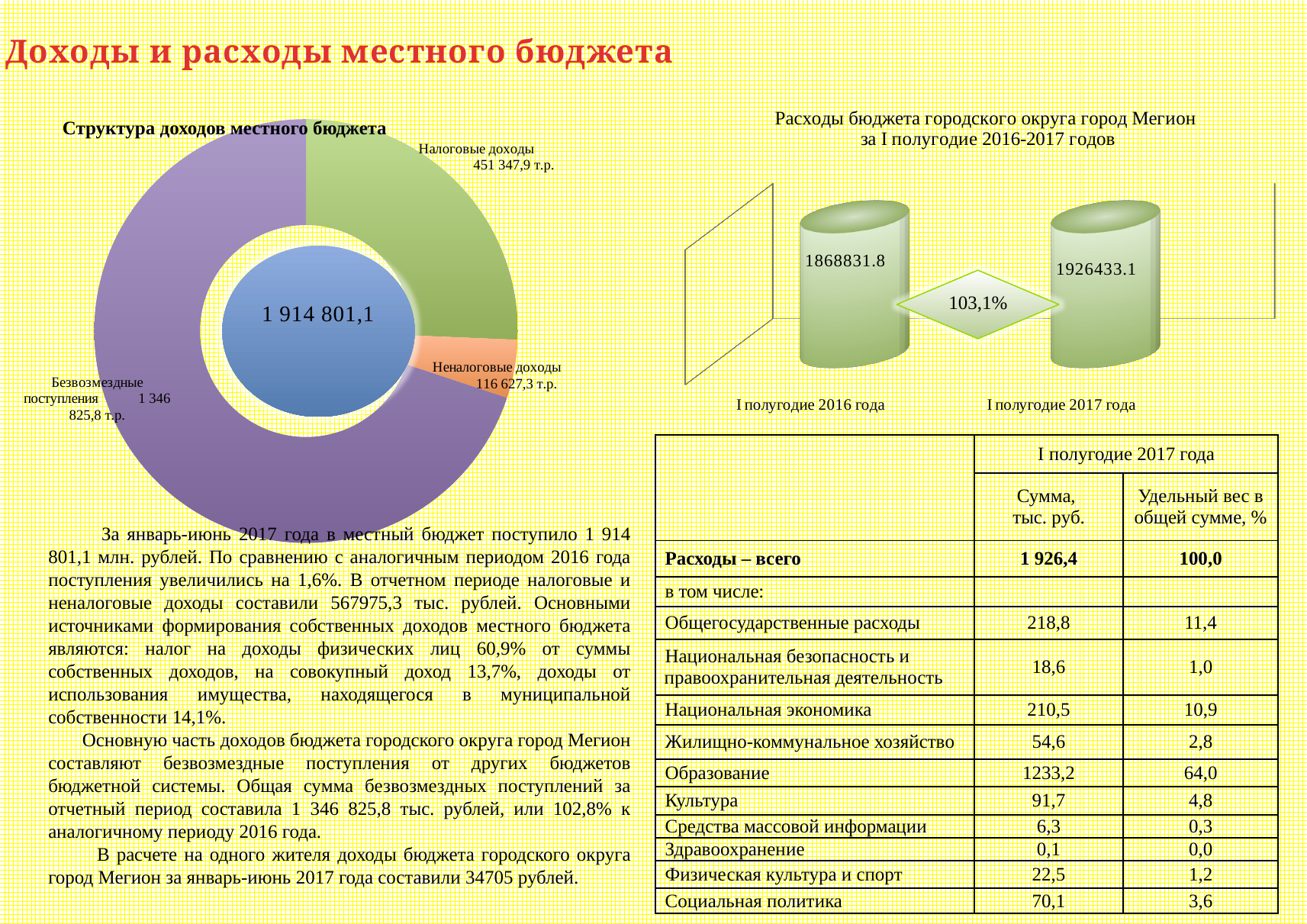
In the donut chart 'Структура доходов местного бюджета', which category has the smallest value? Неналоговые доходы In the chart 'Расходы бюджета городского округа город Мегион за I полугодие 2016-2017 годов', what is the value for I полугодие 2017 года? 1926433.1 In the chart 'Расходы бюджета городского округа город Мегион за I полугодие 2016-2017 годов', what is the value for I полугодие 2016 года? 1868831.8 In the donut chart 'Структура доходов местного бюджета', what is the value for Налоговые доходы? 451 347,9 т.р. In the donut chart 'Структура доходов местного бюджета', what is the value for Безвозмездные поступления? 1 346 825,8 т.р. In the donut chart 'Структура доходов местного бюджета', what is the difference between Налоговые доходы and Неналоговые доходы? 334 720,6 т.р. In the donut chart 'Структура доходов местного бюджета', what total value is shown in the centre? 1 914 801,1 In the chart 'Расходы бюджета городского округа город Мегион за I полугодие 2016-2017 годов', what percentage is shown between the two periods? 103,1% In the donut chart 'Структура доходов местного бюджета', which category has the largest value? Безвозмездные поступления In the donut chart 'Структура доходов местного бюджета', what is the value for Неналоговые доходы? 116 627,3 т.р. In the donut chart 'Структура доходов местного бюджета', how many categories are shown? 3 What kind of chart is 'Структура доходов местного бюджета'? Donut (pie) chart